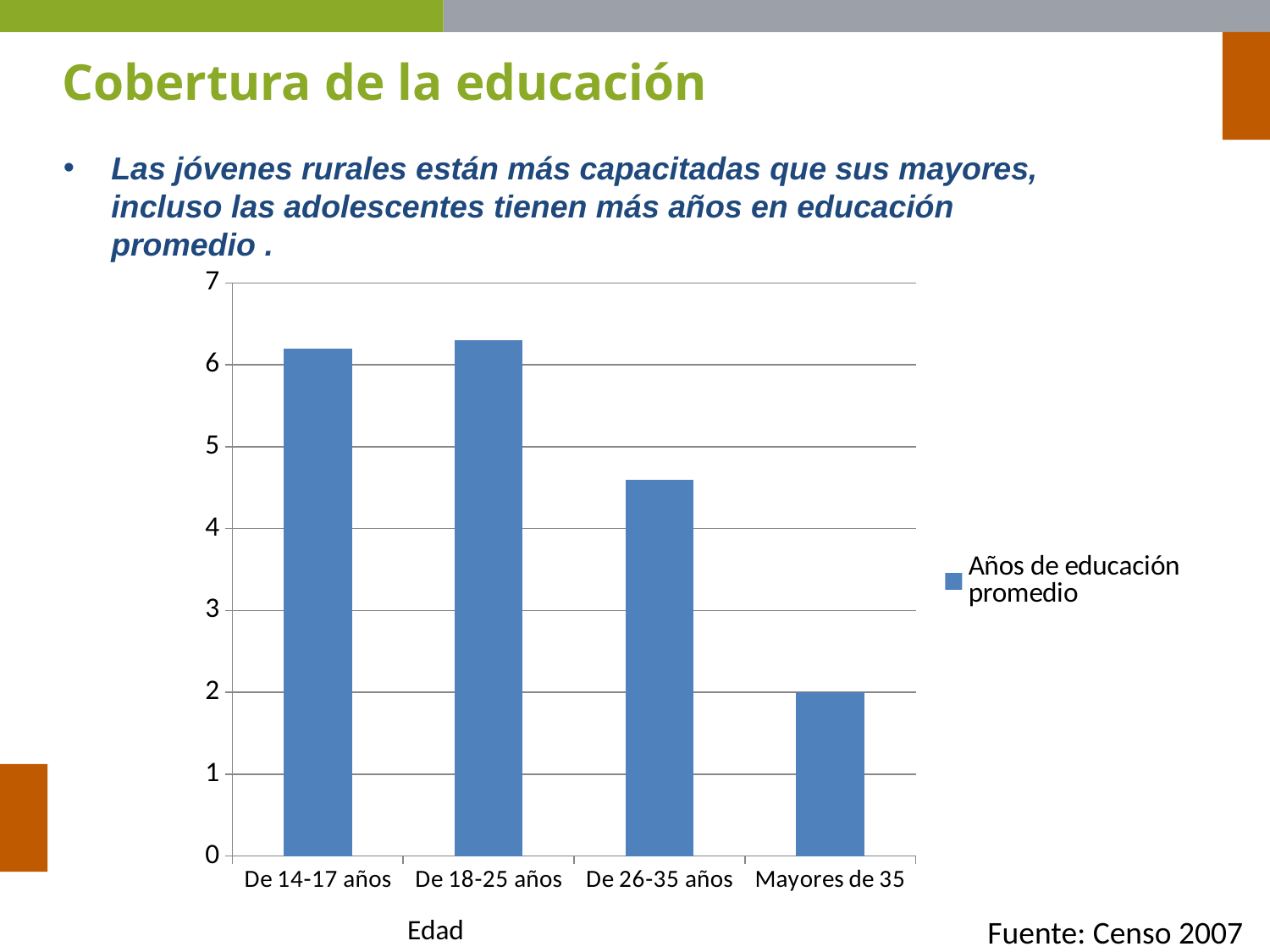
Do the values rise or fall along the x axis from De 18-25 años to Mayores de 35? fall Which has a larger value, De 26-35 años or Mayores de 35? De 26-35 años How many age categories are shown on the x axis of the chart? 4 What kind of chart is shown on the slide? bar chart What is the x-axis title of the chart? Edad Is the value for De 14-17 años greater or less than 6? greater What is the value for Mayores de 35 in the chart? 2 What is the name of the series shown in the chart legend? Años de educación promedio Is the value for De 26-35 años greater or less than 4? greater Is the value for De 26-35 años greater or less than 5? less Which age category has the lowest value in the chart? Mayores de 35 How many series does the chart legend list? 1